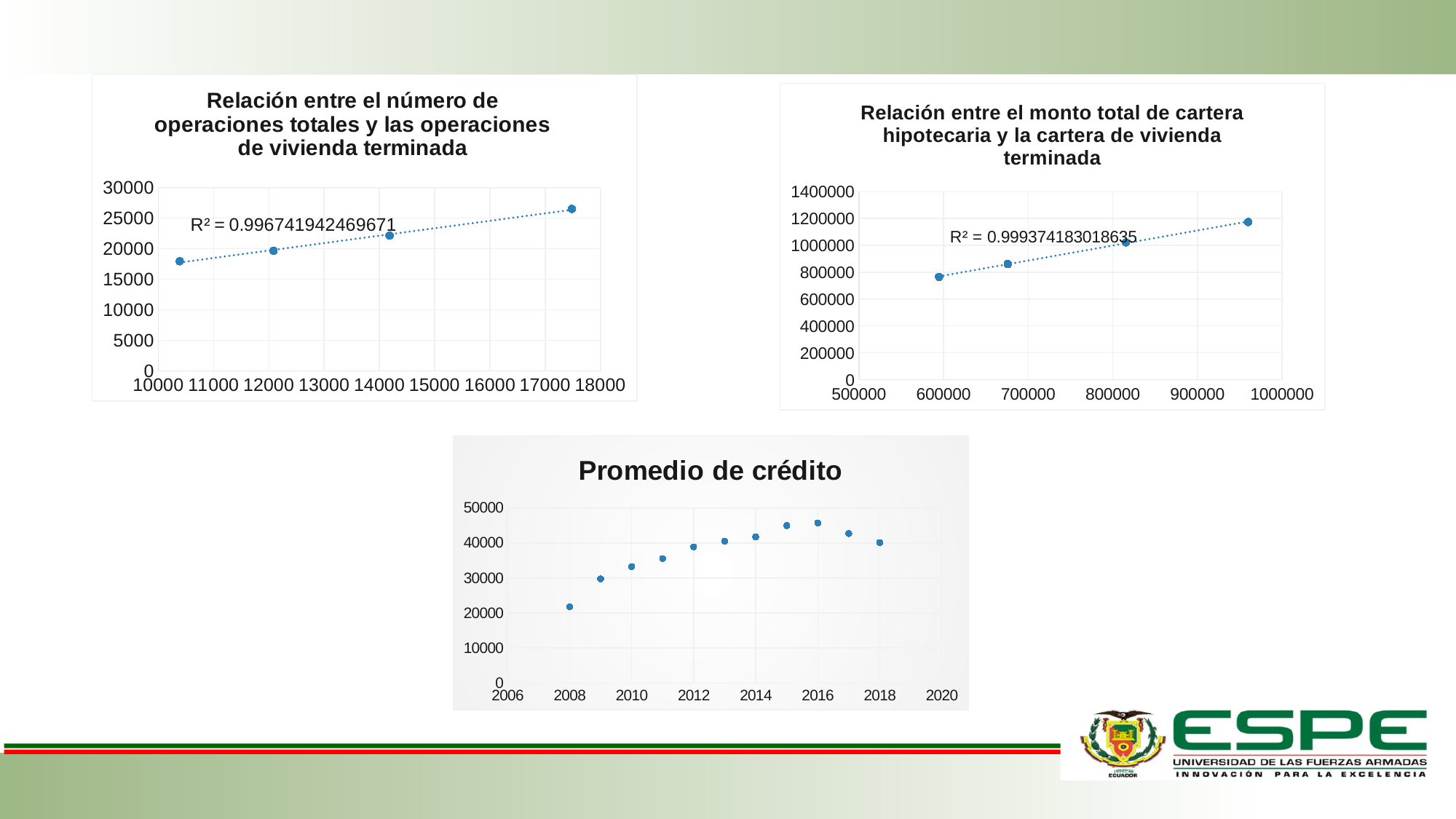
In the chart 'Relación entre el número de operaciones totales y las operaciones de vivienda terminada', what R² value is shown? R² = 0.996741942469671 In the chart 'Relación entre el monto total de cartera hipotecaria y la cartera de vivienda terminada', is the highest plotted point greater or less than 1000000 on the vertical axis? greater In the 'Promedio de crédito' chart, do the values rise or fall from 2008 to 2016? rise In the 'Promedio de crédito' chart, which year has the highest value? 2016 In the chart 'Relación entre el monto total de cartera hipotecaria y la cartera de vivienda terminada', what R² value is shown? R² = 0.999374183018635 In the 'Promedio de crédito' chart, is the value for 2016 greater or less than 40000? greater In the 'Promedio de crédito' chart, is the value for 2008 greater or less than 30000? less In the 'Promedio de crédito' chart, how many data points are plotted? 11 In the chart 'Relación entre el número de operaciones totales y las operaciones de vivienda terminada', how many data points are plotted? 4 What kind of chart is the 'Promedio de crédito' chart? scatter chart In the 'Promedio de crédito' chart, which year has the lowest value? 2008 In the 'Promedio de crédito' chart, which year has the larger value, 2015 or 2018? 2015